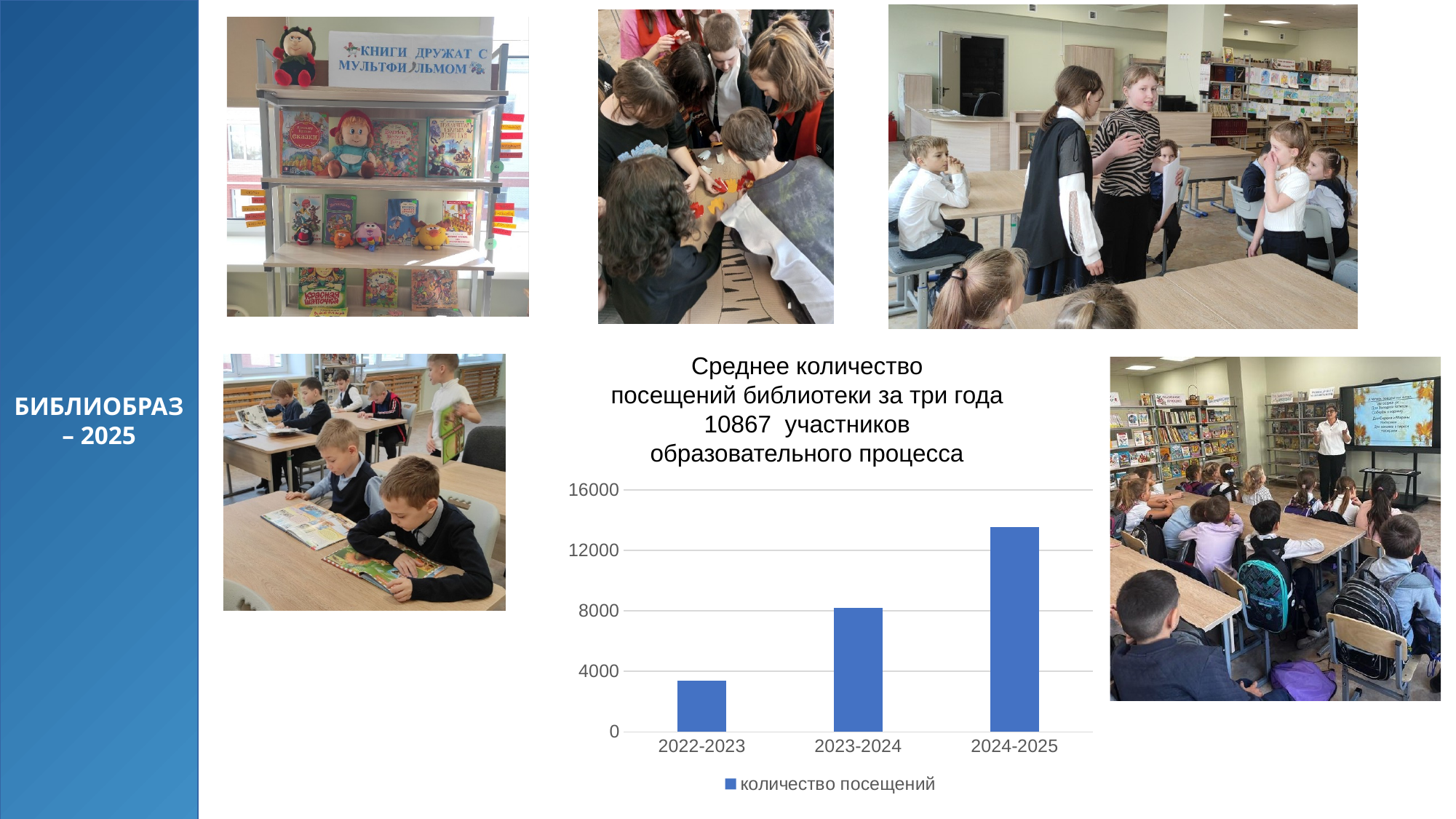
Is the value for 2023-2024 greater or less than 12000? less Is the value for 2022-2023 greater or less than 4000? less Do the values in the chart rise or fall from 2022-2023 to 2024-2025? rise What kind of chart is shown on the slide? bar chart Which academic year has the lowest number of library visits in the chart? 2022-2023 What is the name of the series in the chart legend? количество посещений Which academic year has the highest number of library visits in the chart? 2024-2025 Which is larger, the value for 2023-2024 or the value for 2024-2025? 2024-2025 How many series does the chart legend list? 1 How many categories (academic years) are shown on the x axis of the chart? 3 Is the value for 2024-2025 greater or less than 12000? greater